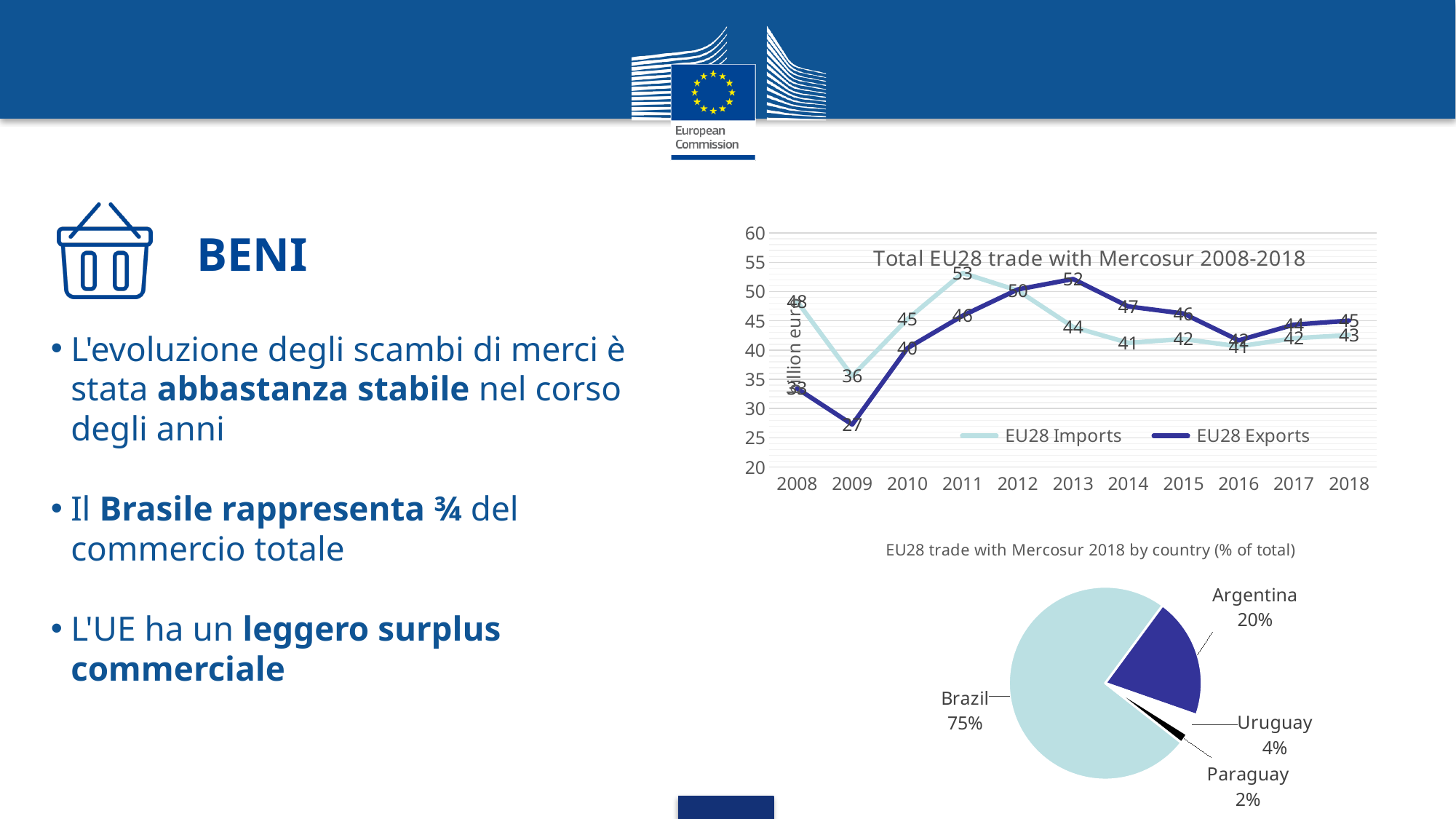
In the 'Total EU28 trade with Mercosur 2008-2018' chart, what is the difference between EU28 Exports and EU28 Imports in 2013? 8 In the 'EU28 trade with Mercosur 2018 by country' pie chart, what share does Brazil have? 75% In the 'Total EU28 trade with Mercosur 2008-2018' chart, do EU28 Imports rise or fall from 2011 to 2014? fall How many years are shown on the x axis of the 'Total EU28 trade with Mercosur 2008-2018' chart? 11 In the 'Total EU28 trade with Mercosur 2008-2018' chart, which is larger in 2018, EU28 Exports or EU28 Imports? EU28 Exports In the 'Total EU28 trade with Mercosur 2008-2018' chart, what is the value of EU28 Imports in 2011? 53 In the 'Total EU28 trade with Mercosur 2008-2018' chart, in which year are EU28 Exports lowest? 2009 How many series does the legend of the 'Total EU28 trade with Mercosur 2008-2018' chart list? 2 In the 'Total EU28 trade with Mercosur 2008-2018' chart, in which year are EU28 Imports highest? 2011 In the 'Total EU28 trade with Mercosur 2008-2018' chart, what is the value of EU28 Exports in 2009? 27 What kind of chart is the 'Total EU28 trade with Mercosur 2008-2018' chart? line chart In the 'EU28 trade with Mercosur 2018 by country' pie chart, which country has the smallest slice? Paraguay